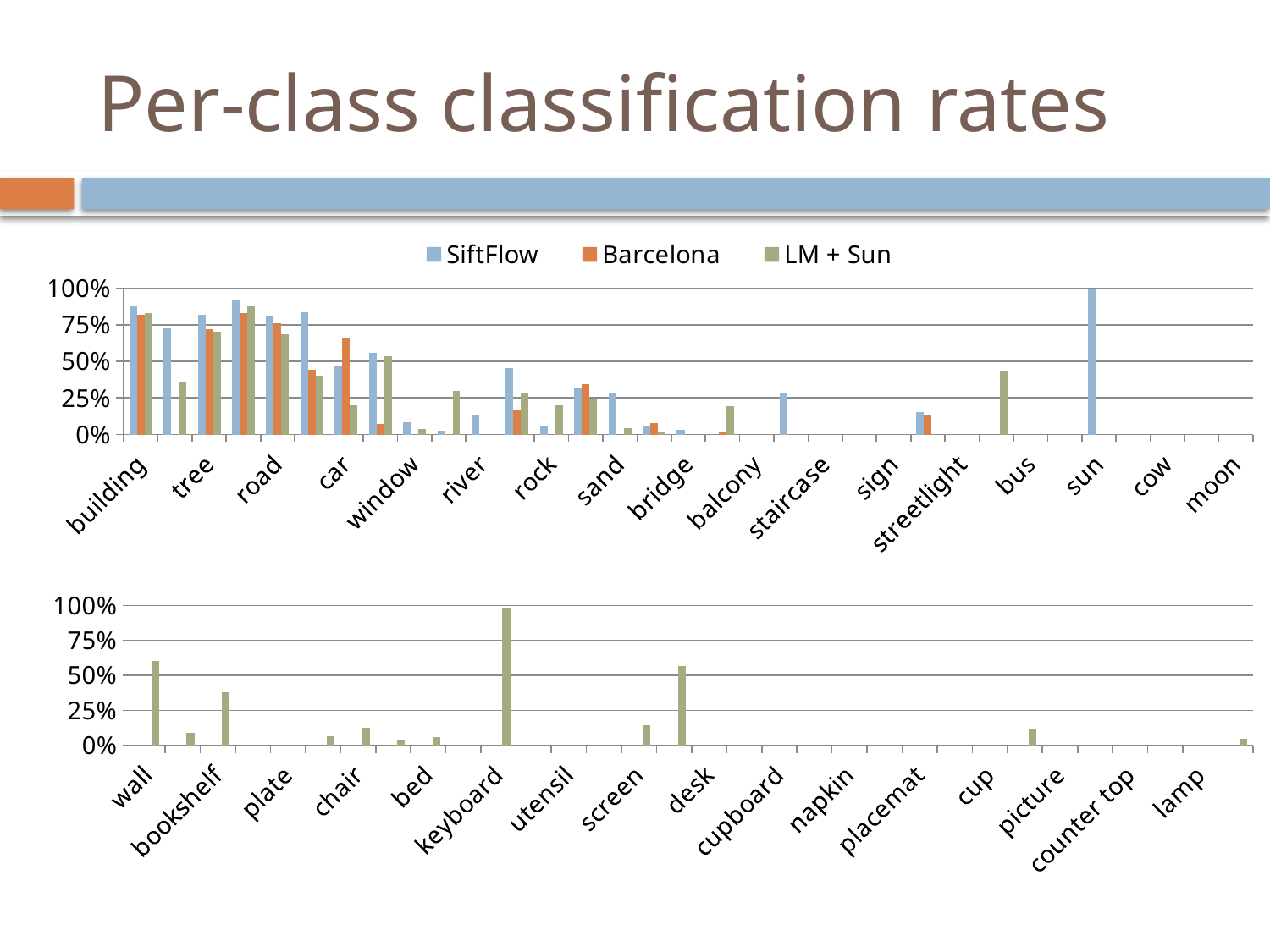
In the top chart, which is larger for car: the SiftFlow value or the Barcelona value? Barcelona What are the series names in the legend of the top chart? SiftFlow, Barcelona, LM + Sun In the top chart, is the Barcelona value for car greater or less than 50%? greater In the bottom chart, is the value for wall greater or less than 50%? greater In the bottom chart, which category has the highest value? keyboard In the top chart, which category has the highest SiftFlow value? sun What kind of chart is the top chart on the slide? bar chart In the bottom chart, which is larger: the value for wall or the value for bookshelf? wall In the top chart, which is larger for car: the SiftFlow value or the LM + Sun value? SiftFlow In the top chart, is the SiftFlow value for building greater or less than 75%? greater How many series does the legend of the top chart list? 3